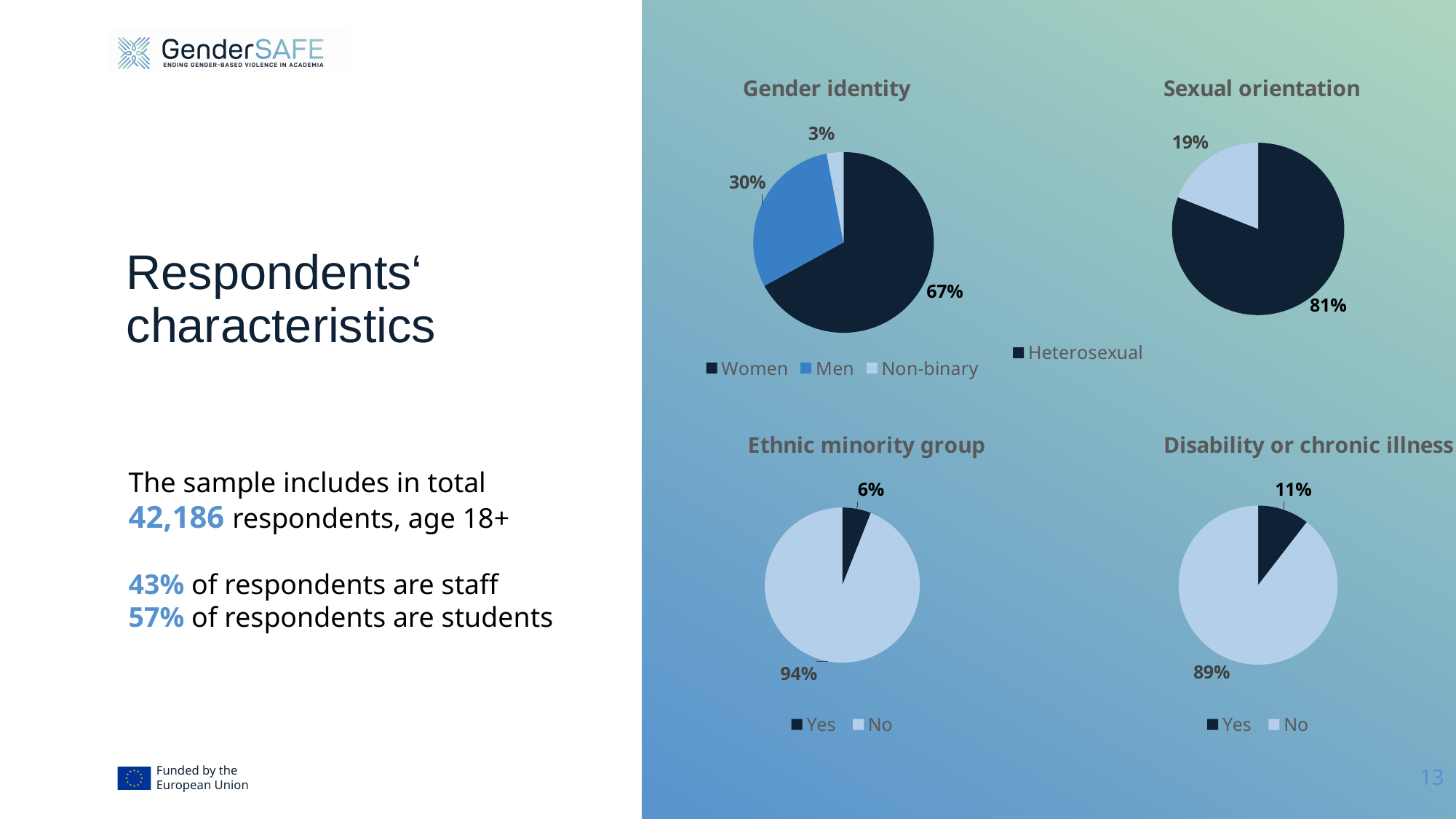
Which is larger: the Yes share in the 'Ethnic minority group' chart or the Yes share in the 'Disability or chronic illness' chart? Disability or chronic illness In the 'Ethnic minority group' chart, what percentage answered Yes? 6% In the 'Gender identity' chart, how many categories does the legend list? 3 In the 'Ethnic minority group' chart, what percentage answered No? 94% In the 'Gender identity' chart, what share of respondents are women? 67% In the 'Disability or chronic illness' chart, what percentage answered Yes? 11% In the 'Gender identity' chart, what is the difference in percentage points between Women and Men? 37 In the 'Gender identity' chart, what percentage is shown for Men? 30% In the 'Gender identity' chart, which category has the smallest slice? Non-binary In the 'Gender identity' chart, what percentage is shown for Non-binary? 3% In the 'Sexual orientation' chart, what percentage of respondents are Heterosexual? 81% What type of chart is used for 'Disability or chronic illness'? Pie chart